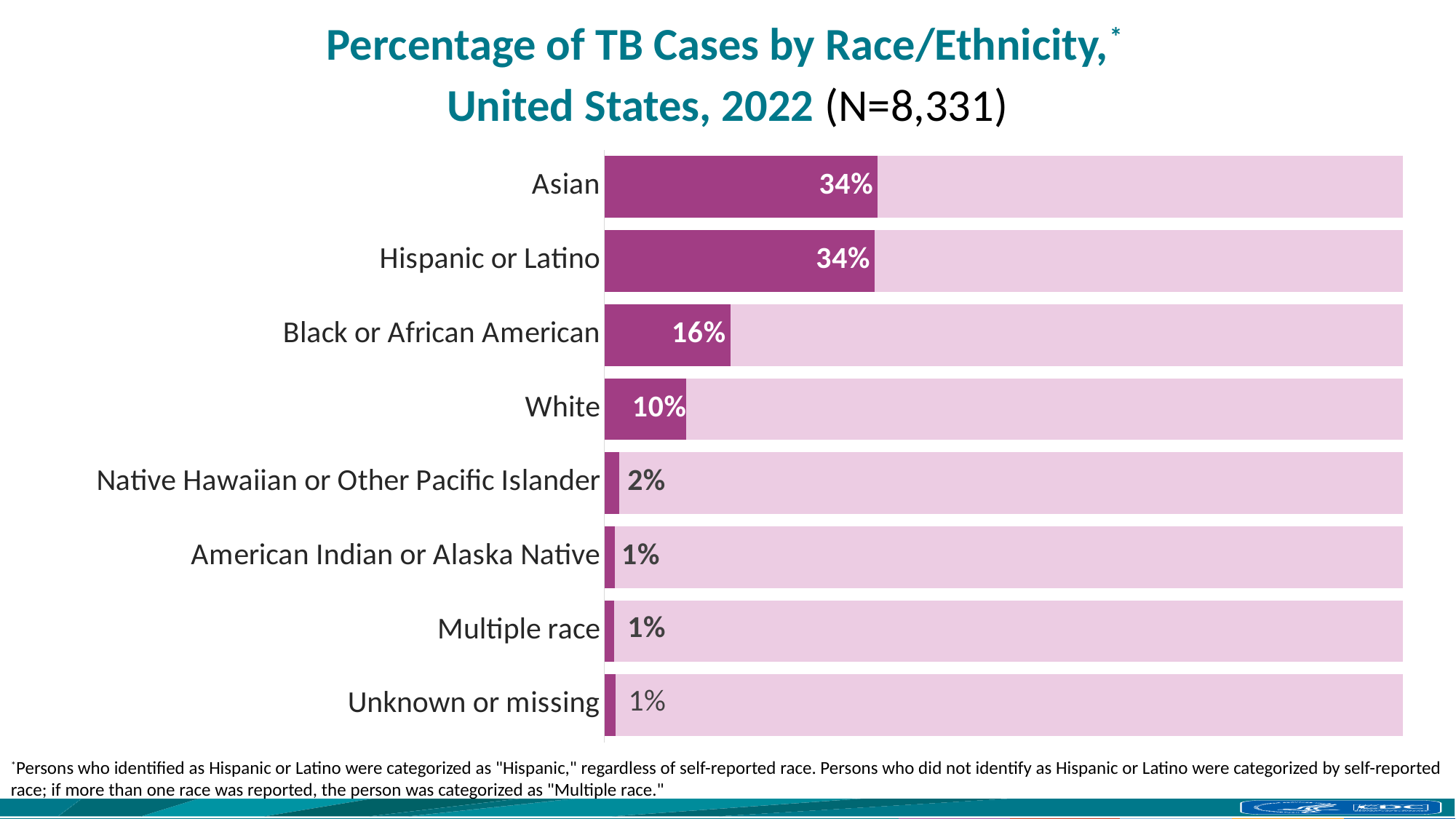
What percentage of TB cases is shown for Unknown or missing? 1% Which has a larger percentage of TB cases, White or Native Hawaiian or Other Pacific Islander? White What is the total number of TB cases (N) given in the chart title? 8,331 What percentage of TB cases is shown for Native Hawaiian or Other Pacific Islander? 2% What is the difference in percentage points between Black or African American and White? 6 What percentage of TB cases is shown for Hispanic or Latino? 34% How many race/ethnicity categories are shown in the chart? 8 Which has a larger percentage of TB cases, Black or African American or White? Black or African American What is the difference in percentage points between Asian and Black or African American? 18 What percentage of TB cases is shown for Black or African American? 16% What kind of chart is shown on the slide? Bar chart What percentage of TB cases is shown for White? 10%